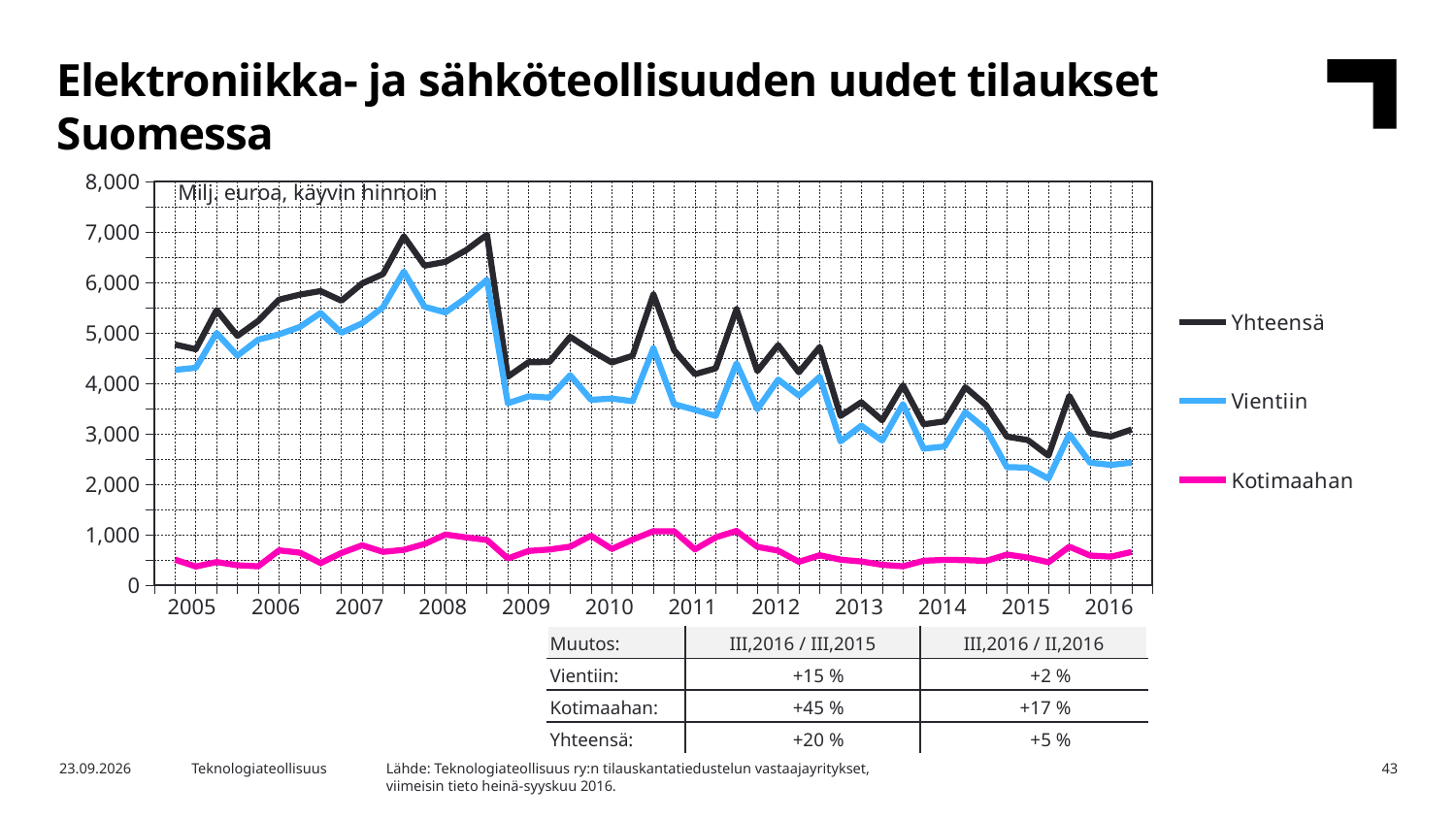
Is the peak value for Yhteensä in 2008 greater or less than 6,000? greater What is the title of the chart? Elektroniikka- ja sähköteollisuuden uudet tilaukset Suomessa What kind of chart is shown on the slide? Line chart What unit label is shown inside the chart area? Milj. euroa, käyvin hinnoin Is the value for Vientiin in 2016 greater or less than 3,000? less Is the value for Kotimaahan in 2010 greater or less than 2,000? less Which series has the highest values throughout the chart? Yhteensä Which series has the lowest values throughout the chart? Kotimaahan How many series does the legend list? 3 Does the Yhteensä series rise or fall overall from 2009 to 2016? fall Which is larger in 2012, Vientiin or Kotimaahan? Vientiin